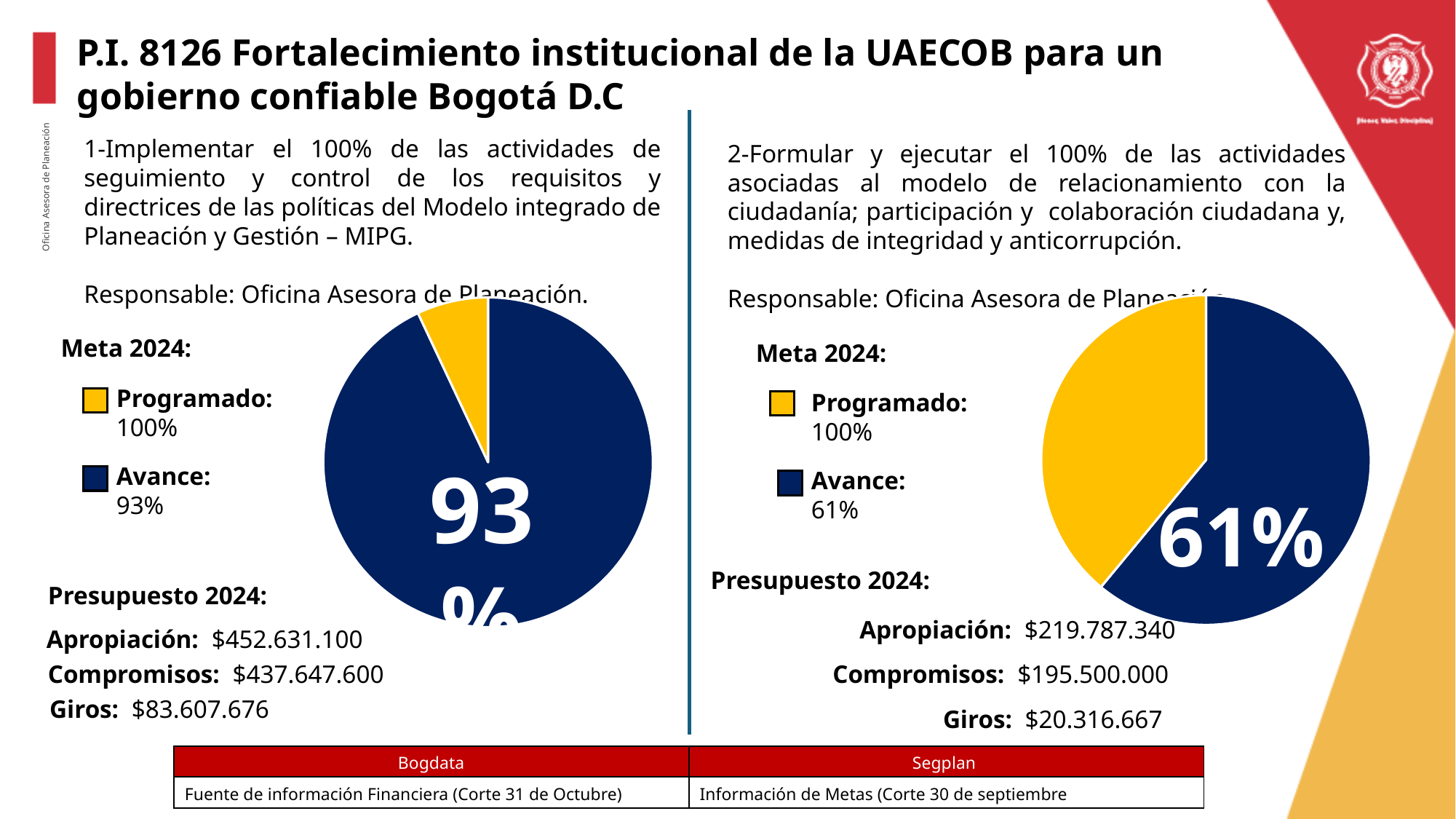
In the left chart (goal 1), what is the difference between the Programado value and the Avance value? 7 percentage points In the right pie chart (goal 2), which slice is larger, the dark blue Avance slice or the yellow slice? dark blue Avance slice How many entries does the legend of the right pie chart (goal 2) list? 2 What kind of chart is shown on the left side of the slide (under goal 1)? pie chart What kind of chart is shown on the right side of the slide (under goal 2)? pie chart How many slices does the left pie chart (goal 1) have? 2 In the right chart's legend (goal 2), what is the Programado value? 100% Which is larger, the Avance in the left pie chart (goal 1) or the Avance in the right pie chart (goal 2)? left pie chart (goal 1), 93% In the left pie chart (goal 1), what is the Avance value shown in the centre? 93% In the left chart's legend (goal 1), what is the Programado value? 100% In the right pie chart (goal 2), what is the Avance value shown in the centre? 61% In the pie charts, what colour represents Avance? dark blue